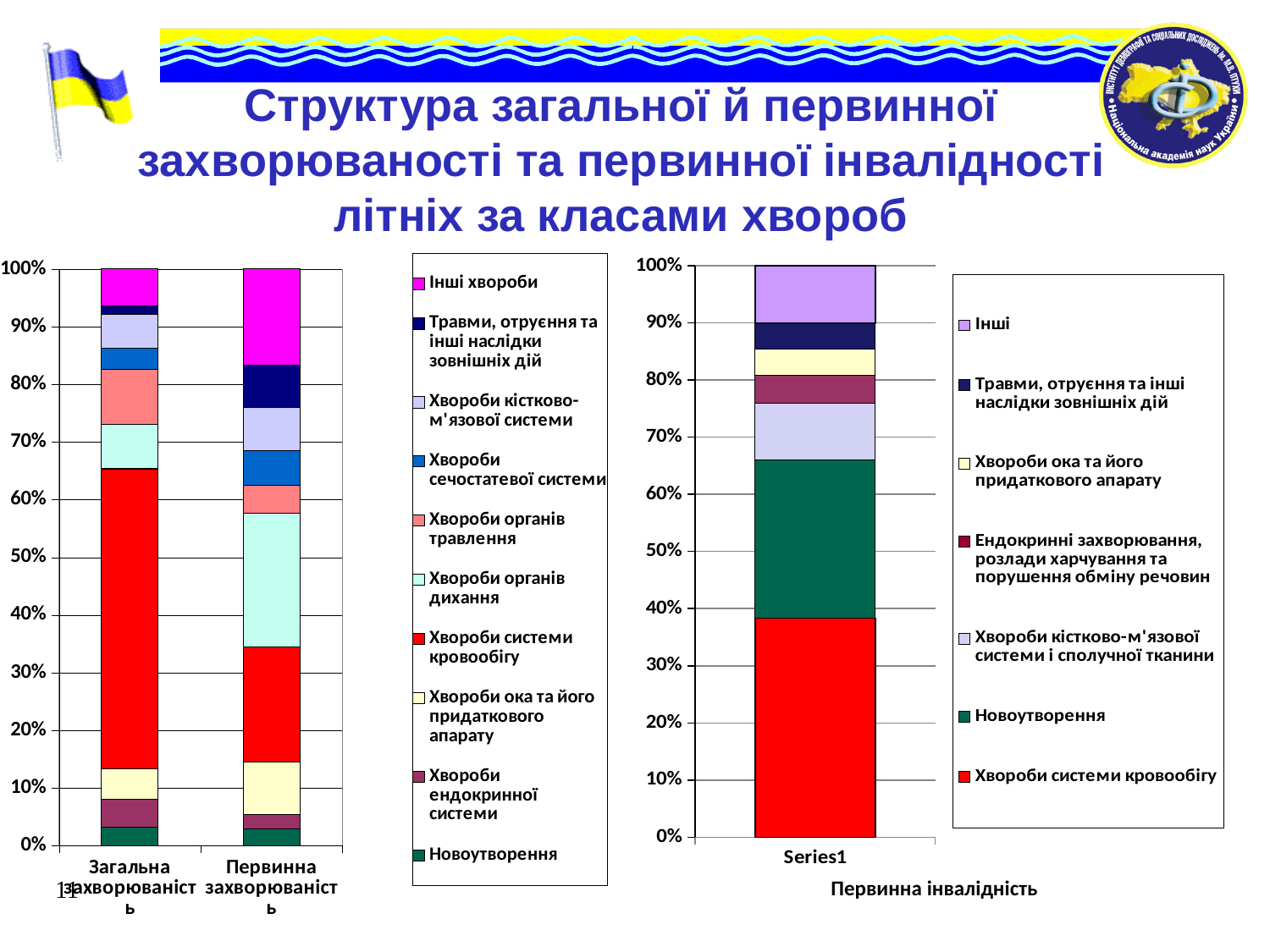
In the right chart (Первинна інвалідність), is the share of Хвороби системи кровообігу greater or less than 30%? greater In the left chart, is the share of Хвороби органів дихання larger for Загальна захворюваність or for Первинна захворюваність? Первинна захворюваність What kind of chart is the left chart on the slide? Stacked bar chart How many series does the legend of the right chart (Первинна інвалідність) list? 7 In the right chart (Первинна інвалідність), which class of disease has the largest segment of the bar? Хвороби системи кровообігу In the right chart (Первинна інвалідність), is the share of Новоутворення greater or less than 20%? greater In the left chart, is the share of Хвороби системи кровообігу for Загальна захворюваність greater or less than 40%? greater How many bars (categories) does the left chart show? 2 In the left chart, is the share of Хвороби системи кровообігу larger for Загальна захворюваність or for Первинна захворюваність? Загальна захворюваність How many bars does the right chart (Первинна інвалідність) show? 1 What is the axis title shown below the right chart? Первинна інвалідність How many series does the legend of the left chart list? 10